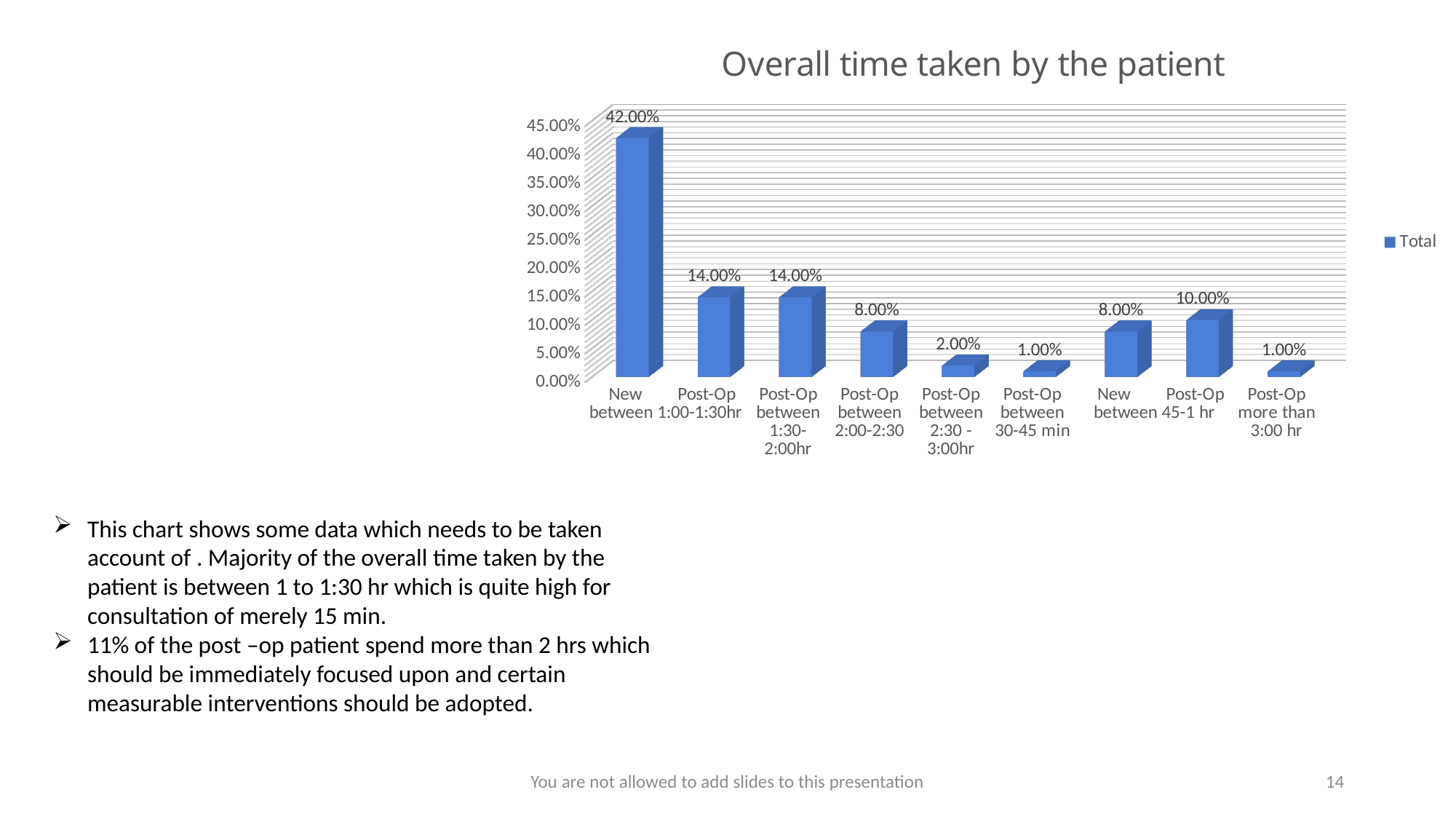
How many series does the legend list? 1 What is the highest value shown in the chart? 42.00% What is the value for Post-Op more than 3:00 hr? 1.00% What is the value for Post-Op between 2:00-2:30? 8.00% What is the value for Post-Op 1:00-1:30hr? 14.00% What is the difference between the values for Post-Op 45-1 hr and Post-Op between 2:00-2:30? 2.00% What is the value for Post-Op 45-1 hr? 10.00% What is the value for Post-Op between 2:30 - 3:00hr? 2.00% What kind of chart is shown on the slide? Bar chart What is the title of the chart? Overall time taken by the patient What is the value for Post-Op between 1:30-2:00hr? 14.00% How many categories are plotted in the chart? 9